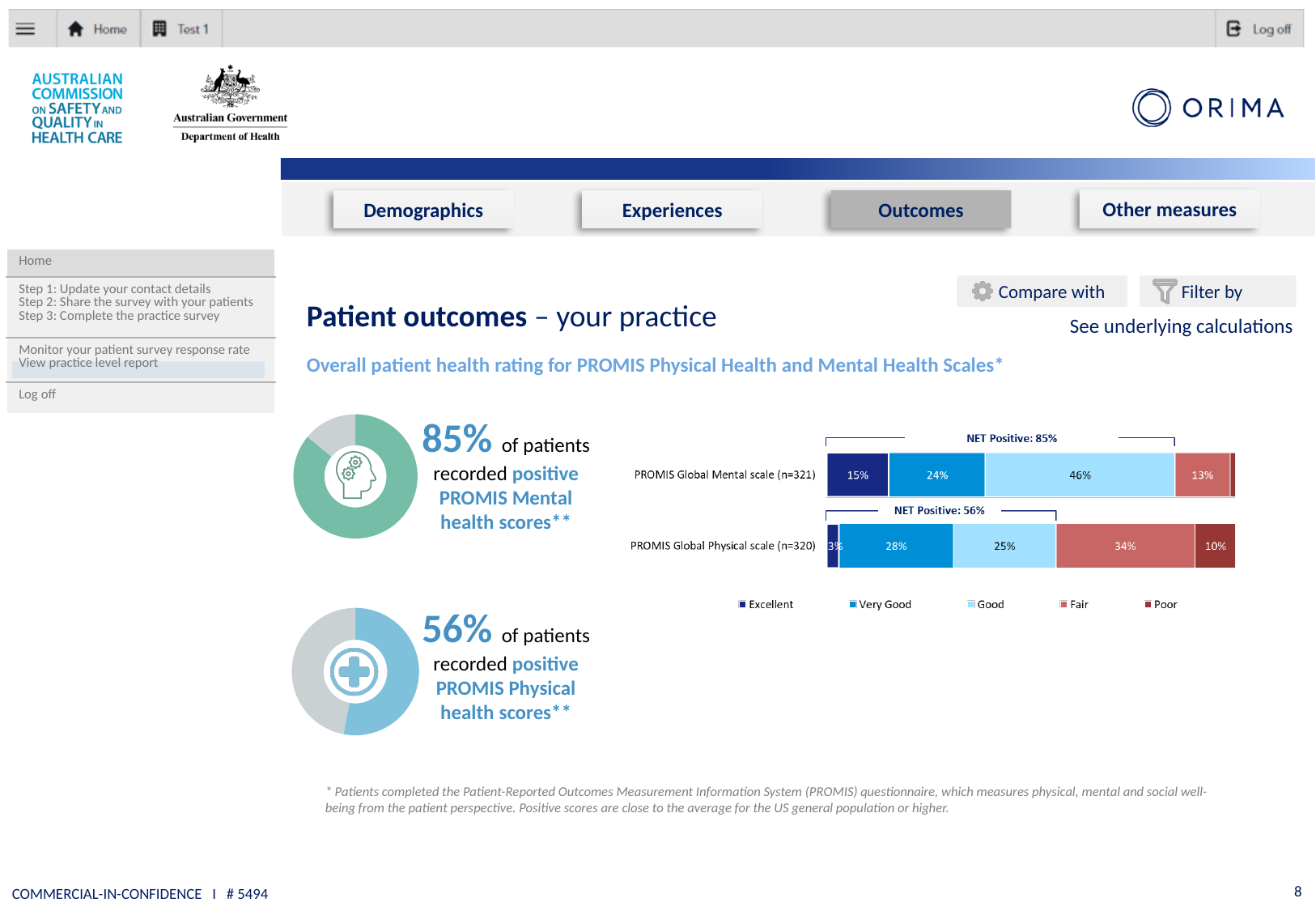
In the stacked bar chart, what percentage of patients rated 'Very Good' on the PROMIS Global Mental scale? 24% In the stacked bar chart, what percentage of patients rated 'Poor' on the PROMIS Global Physical scale? 10% In the stacked bar chart, which rating category has the largest share on the PROMIS Global Mental scale? Good How many series does the legend of the stacked bar chart list? 5 In the stacked bar chart, is the 'Very Good' share larger for the PROMIS Global Mental scale or the PROMIS Global Physical scale? PROMIS Global Physical scale In the stacked bar chart, what percentage of patients rated 'Fair' on the PROMIS Global Physical scale? 34% In the stacked bar chart, what percentage of patients rated 'Good' on the PROMIS Global Mental scale? 46% In the stacked bar chart, which rating category has the largest share on the PROMIS Global Physical scale? Fair In the stacked bar chart, what is the NET Positive value shown for the PROMIS Global Physical scale? 56% What kind of chart is used to show the PROMIS Global Mental and Physical scale ratings? Stacked bar chart In the stacked bar chart, what is the difference between the 'Excellent' share on the PROMIS Global Mental scale and on the PROMIS Global Physical scale? 12% In the stacked bar chart, what is the NET Positive value shown for the PROMIS Global Mental scale? 85%